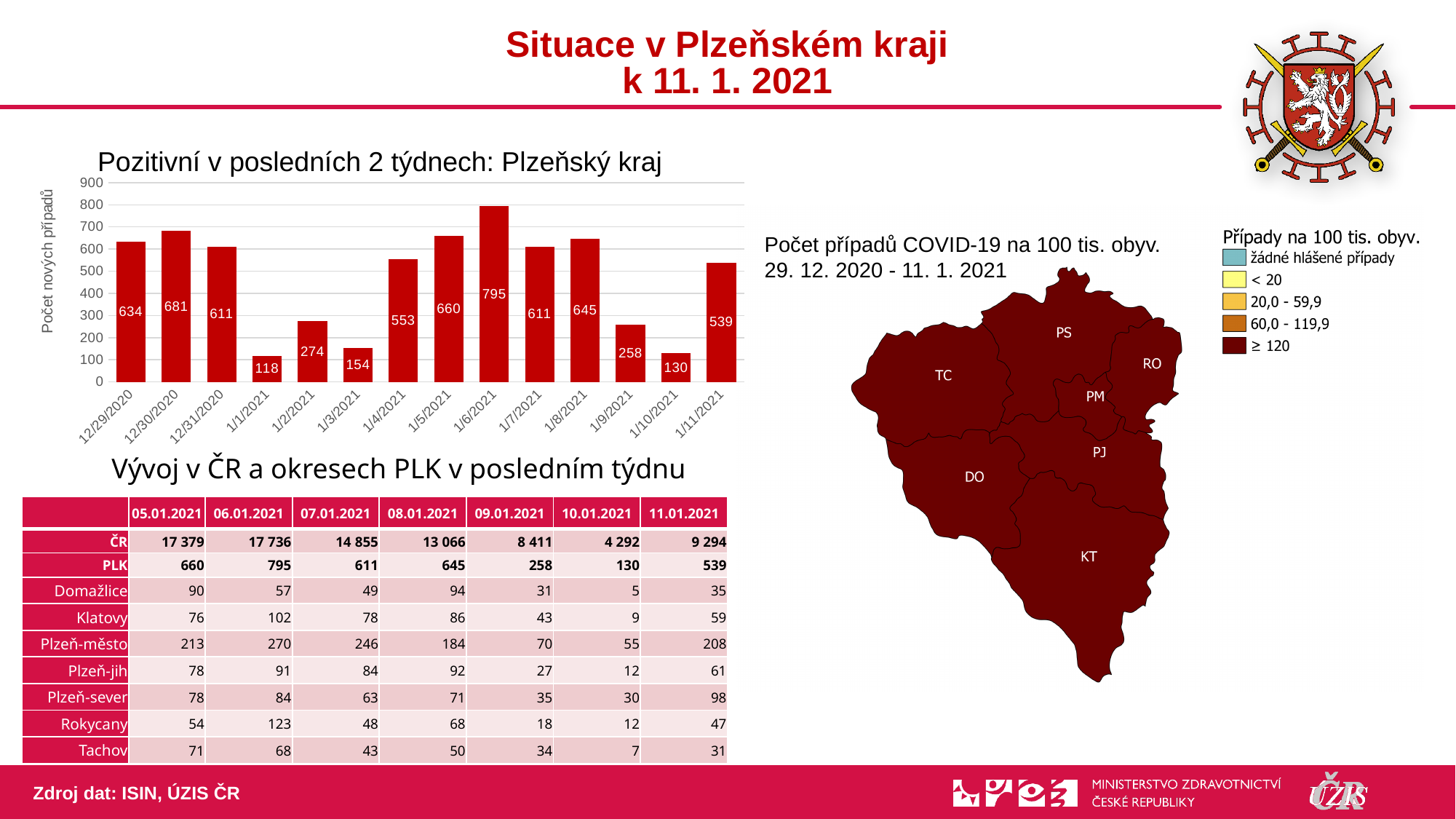
Which date has the highest value in the bar chart? 1/6/2021 What kind of chart is 'Pozitivní v posledních 2 týdnech: Plzeňský kraj'? bar chart Is the value for 1/11/2021 in the bar chart greater or less than 500? greater What is the value for 12/29/2020 in the bar chart? 634 How many dates are shown on the x axis of the bar chart? 14 What is the value for 1/10/2021 in the bar chart? 130 What is the y-axis title of the bar chart? Počet nových případů What is the difference between the values for 12/30/2020 and 1/1/2021 in the bar chart? 563 What is the value for 1/6/2021 in the chart 'Pozitivní v posledních 2 týdnech: Plzeňský kraj'? 795 Which is larger in the bar chart, the value for 1/2/2021 or the value for 1/9/2021? 1/2/2021 Which date has the lowest value in the bar chart? 1/1/2021 What is the difference between the values for 1/6/2021 and 1/5/2021 in the bar chart? 135